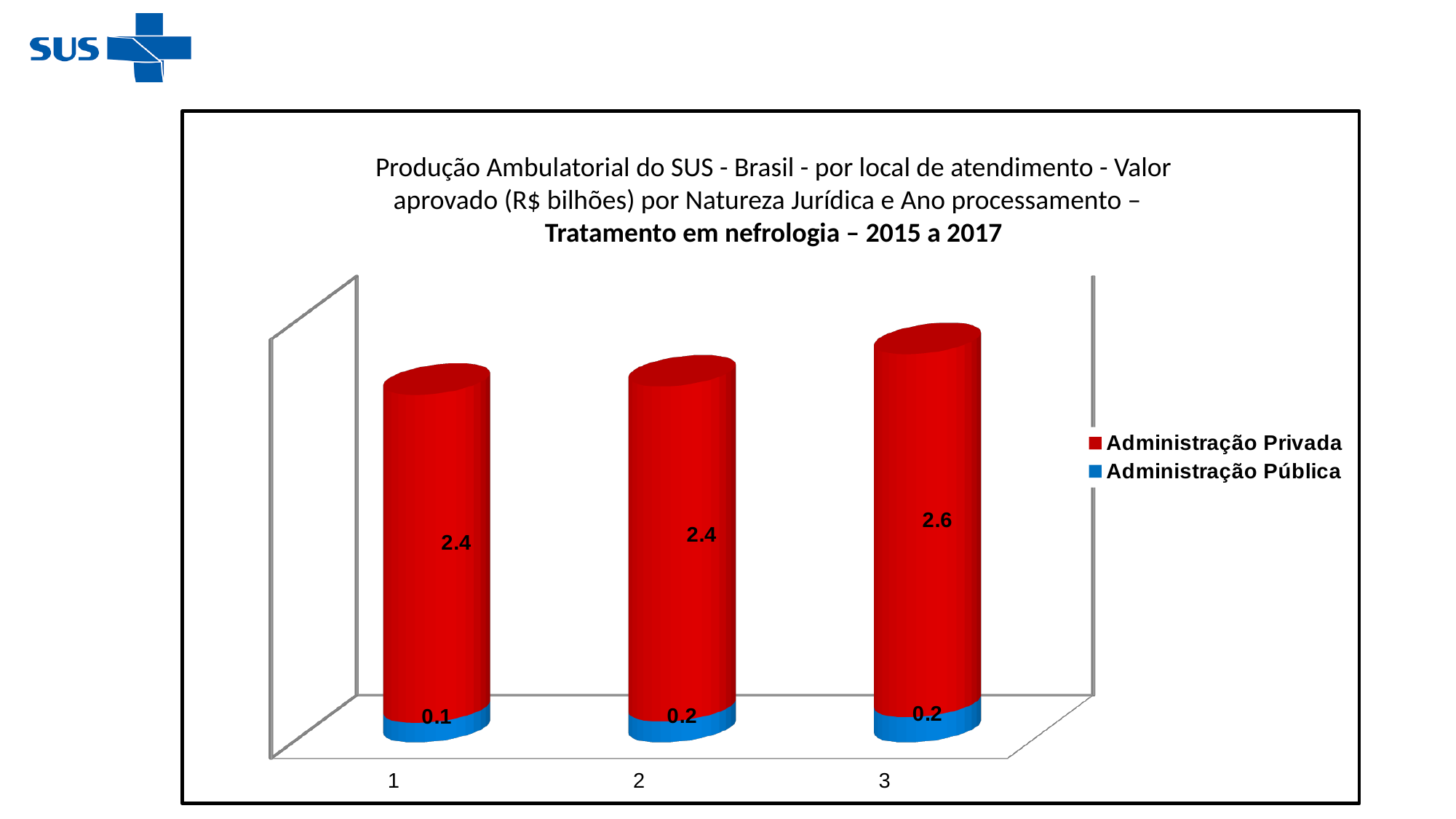
What is the value for Administração Privada at category 1? 2.4 What is the difference between the Administração Privada values at category 3 and category 1? 0.2 What is the value for Administração Pública at category 1? 0.1 Which category has the highest value for Administração Privada? 3 What is the value for Administração Pública at category 2? 0.2 Which is larger at category 2: Administração Privada or Administração Pública? Administração Privada Which category has the lowest value for Administração Pública? 1 What is the total of the stacked bar at category 3? 2.8 How many categories are shown on the x axis? 3 How many series does the legend list? 2 What is the value for Administração Privada at category 3? 2.6 What kind of chart is shown on the slide? Stacked bar chart